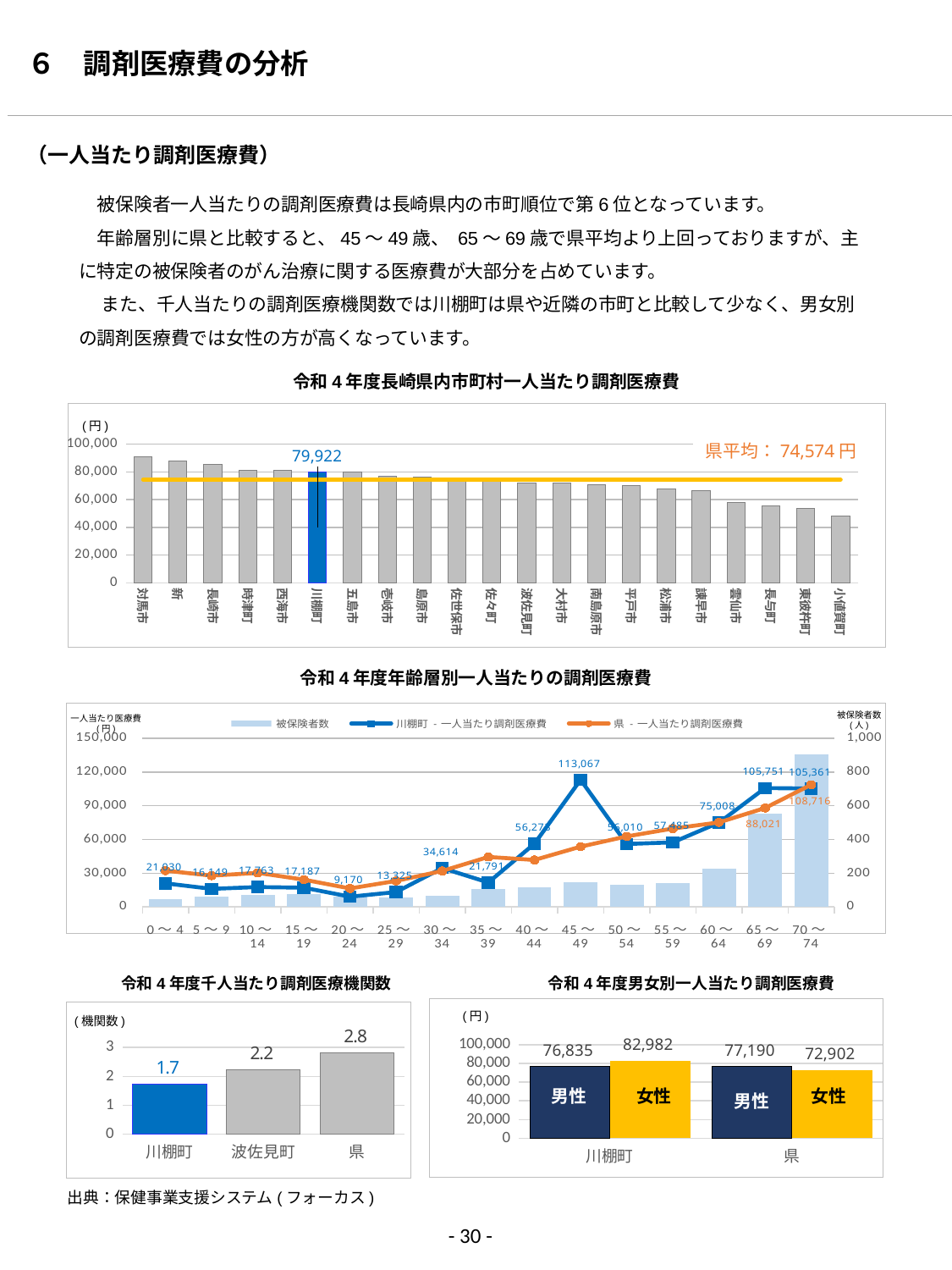
In the chart titled 令和4年度男女別一人当たり調剤医療費, which is larger for 県, 男性 or 女性? 男性 In the chart titled 令和4年度男女別一人当たり調剤医療費, what is the value for 女性 in 川棚町? 82,982 In the chart titled 令和4年度長崎県内市町村一人当たり調剤医療費, what is the 県平均 value shown? 74,574円 In the chart titled 令和4年度年齢層別一人当たりの調剤医療費, how many series does the legend list? 3 In the chart titled 令和4年度年齢層別一人当たりの調剤医療費, what is the 川棚町 value for the 45～49 age group? 113,067 In the chart titled 令和4年度長崎県内市町村一人当たり調剤医療費, which municipality has the highest bar? 対馬市 In the chart titled 令和4年度長崎県内市町村一人当たり調剤医療費, is the value for 小値賀町 greater or less than 60,000? less In the chart titled 令和4年度千人当たり調剤医療機関数, what is the difference between 県 and 川棚町? 1.1 In the chart titled 令和4年度千人当たり調剤医療機関数, what is the value for 川棚町? 1.7 In the chart titled 令和4年度長崎県内市町村一人当たり調剤医療費, which municipality has the lowest bar? 小値賀町 In the chart titled 令和4年度長崎県内市町村一人当たり調剤医療費, what is the value shown for 川棚町? 79,922 In the chart titled 令和4年度年齢層別一人当たりの調剤医療費, what is the 県 value for the 70～74 age group? 108,716